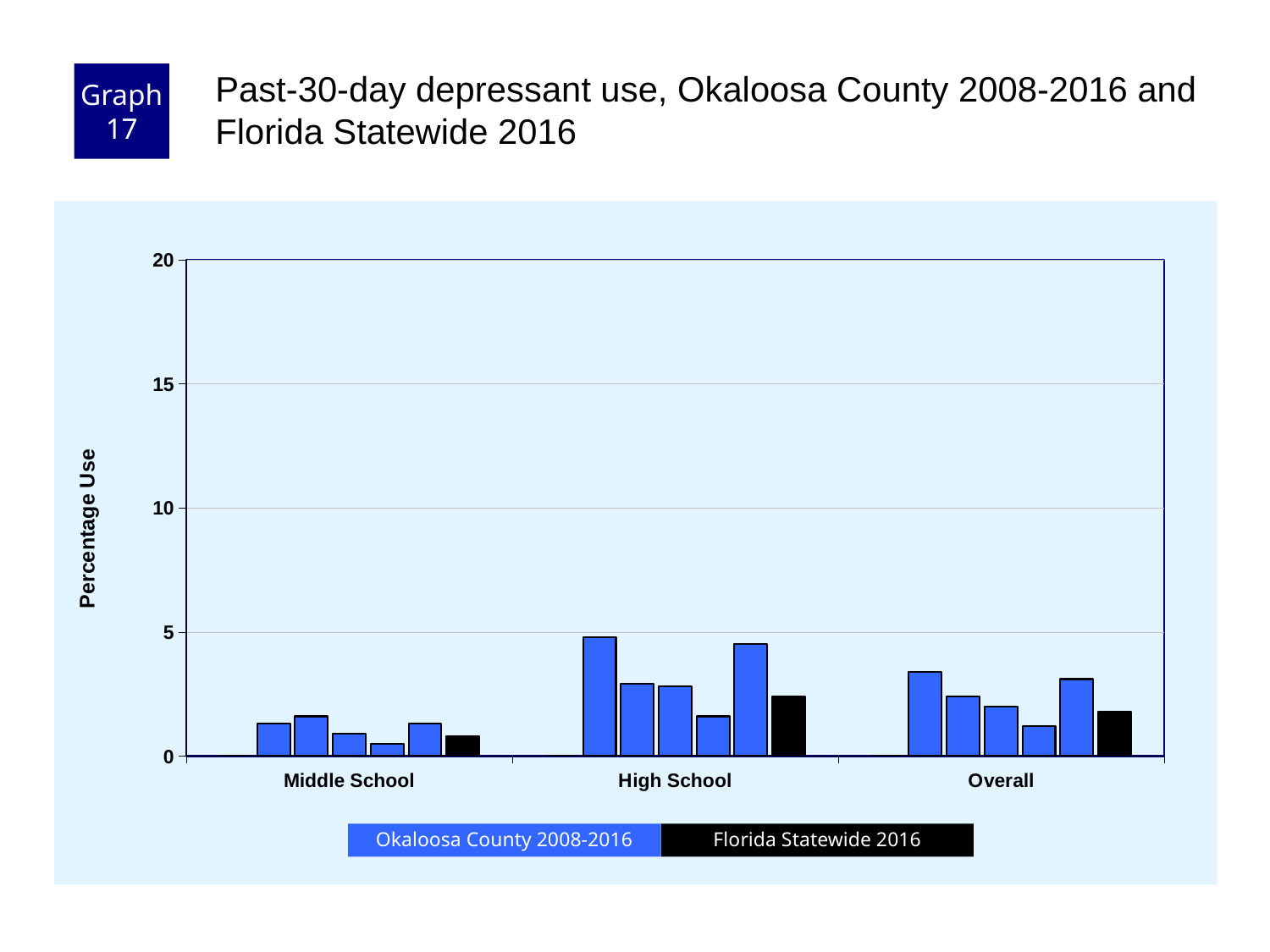
What is the title of the y axis? Percentage Use How many series does the legend list? 2 How many categories are shown on the x axis? 3 What colour are the Florida Statewide 2016 bars? black Which category has the highest Florida Statewide 2016 bar? High School Is the Florida Statewide 2016 value for Middle School greater or less than 5? less What kind of chart is shown on the slide? bar chart Which category has the lowest Florida Statewide 2016 bar? Middle School Is the Florida Statewide 2016 value for High School greater or less than 5? less Which is larger, the Florida Statewide 2016 value for Overall or for Middle School? Overall Which is larger, the Florida Statewide 2016 value for High School or for Middle School? High School Is the tallest Okaloosa County bar in the High School group greater or less than 10? less